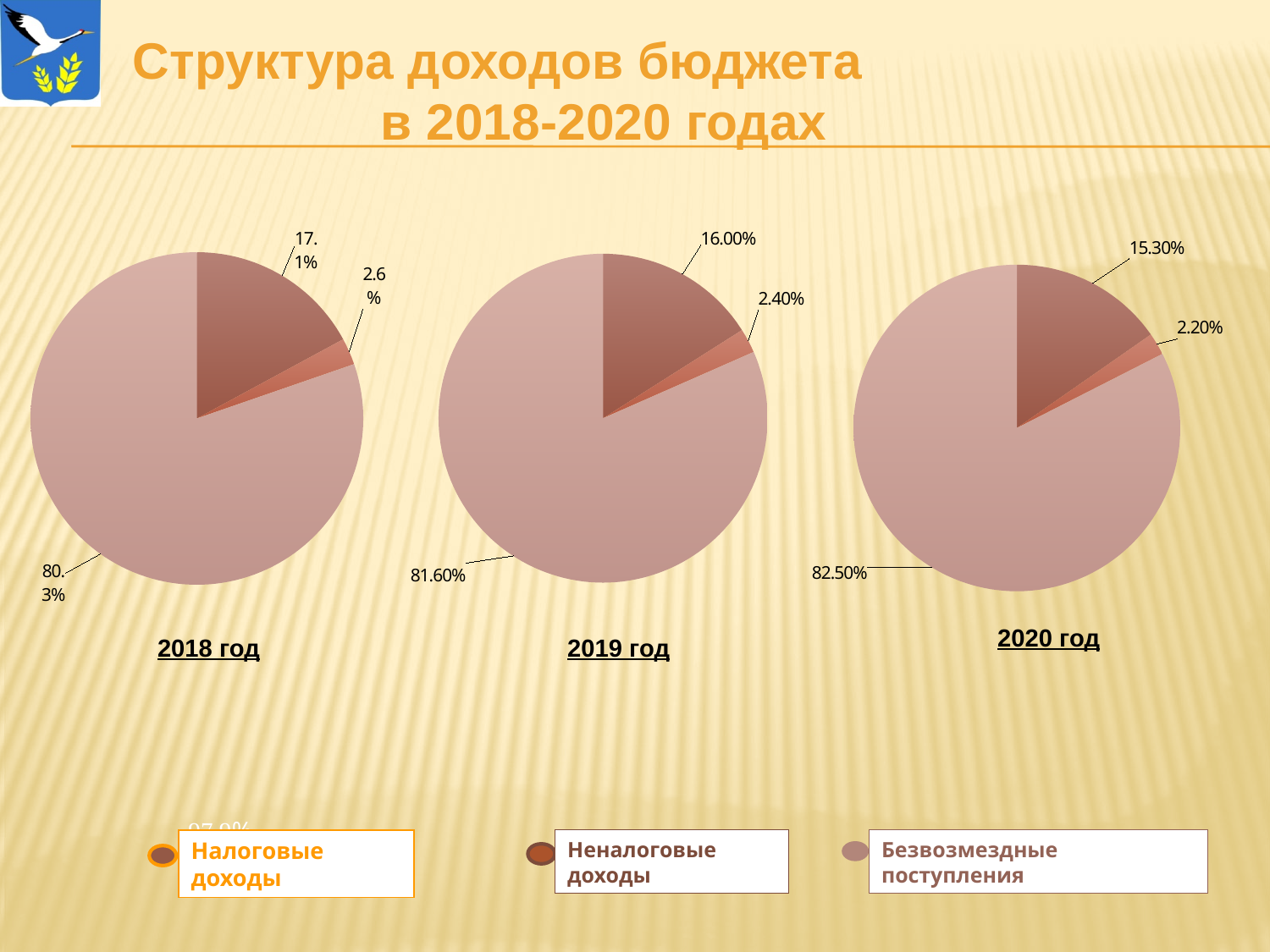
What is the difference between the largest slice in the 2020 год chart and the largest slice in the 2019 год chart? 0.90% In the 2019 год pie chart, what is the share of the medium-sized (dark brown) slice? 16.00% How many categories does the legend list? 3 In the 2020 год pie chart, what is the share of the smallest slice? 2.20% In the 2020 год pie chart, what is the share of the largest slice? 82.50% Across the three pie charts, does the share of the largest slice rise or fall from 2018 to 2020? Rises How many pie charts are on the slide? 3 In the 2018 год pie chart, what is the share of the smallest slice? 2.6% Which legend category corresponds to the largest slice in all three pie charts? Безвозмездные поступления What kind of charts are shown on the slide? Pie charts In the 2019 год pie chart, what is the share of the largest slice? 81.60% In the 2018 год pie chart, what is the share of the largest slice? 80.3%